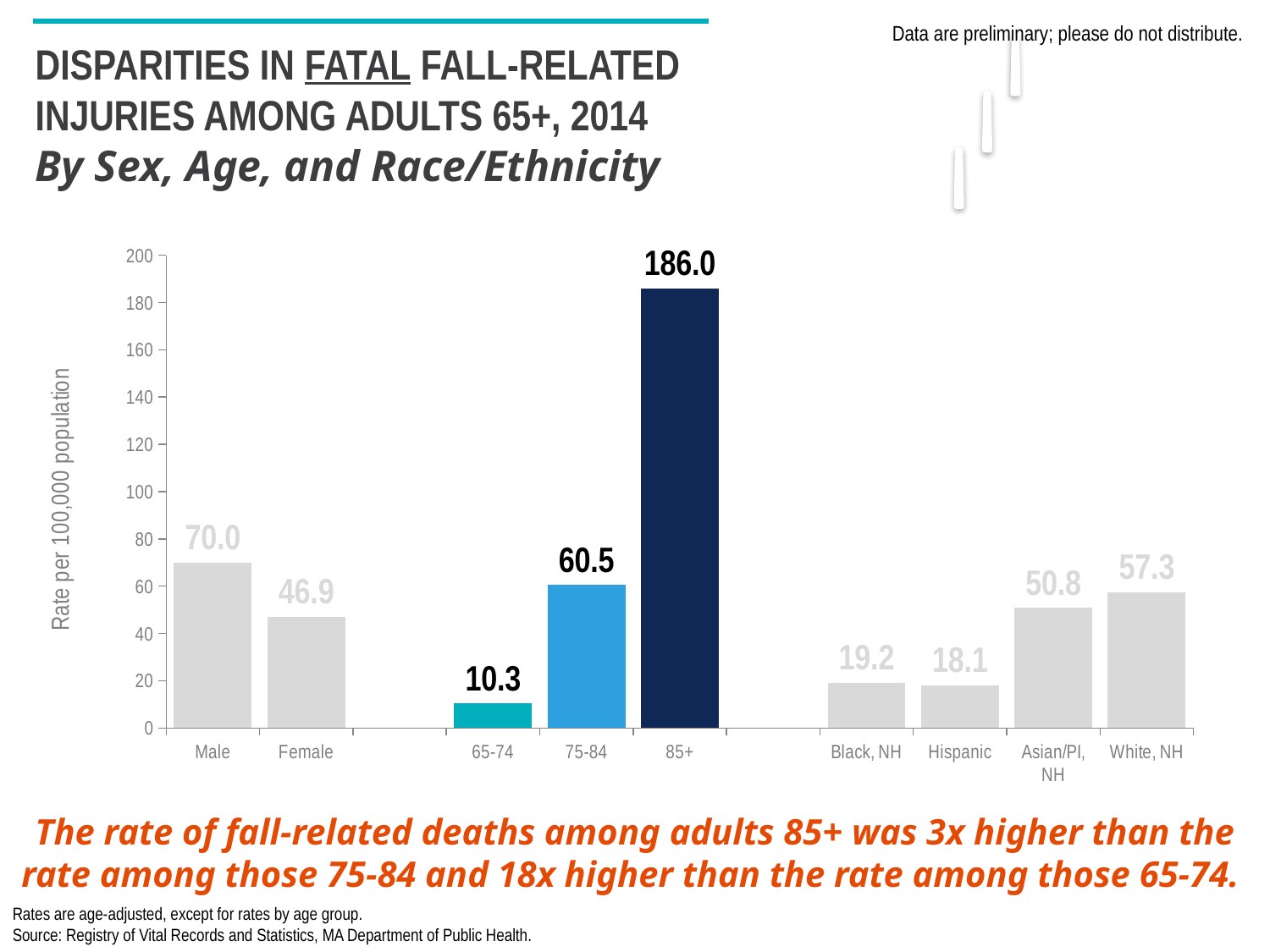
Is the value for 75-84 greater or less than 40? greater What is the fatal fall-related injury rate for adults 85+? 186.0 What is the label of the vertical axis? Rate per 100,000 population What kind of chart is shown on the slide? bar chart What is the rate for the Hispanic group? 18.1 Which category has the highest rate? 85+ How many categories are plotted in the chart? 9 What is the difference between the rates for the 85+ and 75-84 age groups? 125.5 Which category has the lowest rate? 65-74 Which has a higher rate, White, NH or Asian/PI, NH? White, NH What is the difference between the rates for Males and Females? 23.1 What is the rate for Males? 70.0